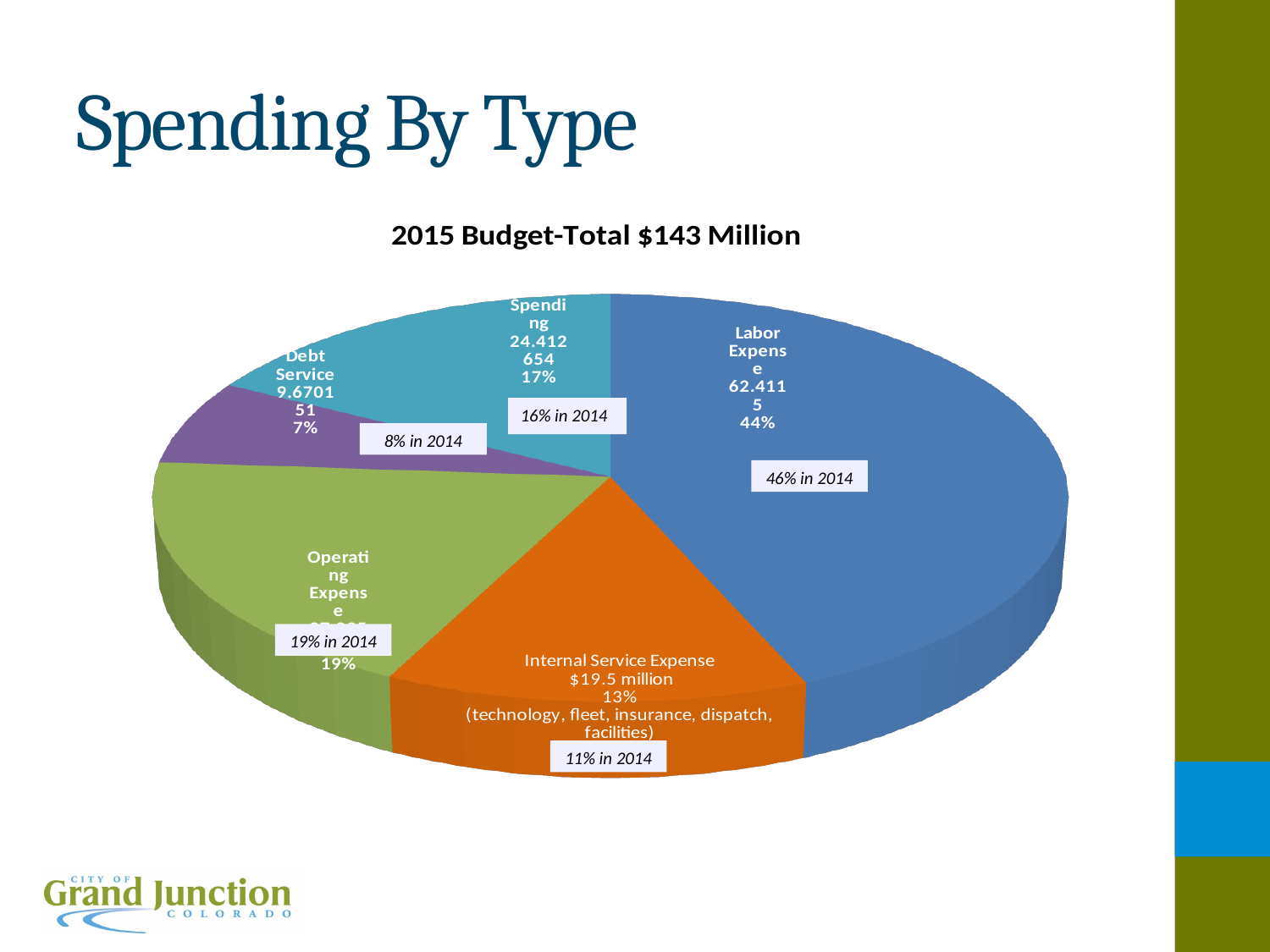
What share of the pie does Internal Service Expense represent? 13% What is the title of the chart? 2015 Budget-Total $143 Million What value is printed on the Debt Service slice? 9.670151 Which is larger, the Operating Expense share or the Internal Service Expense share? Operating Expense How many slices does the pie chart have? 5 What share of the pie does Debt Service represent? 7% Which slice is the largest in the pie chart? Labor Expense What share of the pie does Labor Expense represent? 44% What kind of chart is shown on the slide? Pie chart Which slice is the smallest in the pie chart? Debt Service What value is printed on the Labor Expense slice? 62.4115 According to the callout box, what was the Labor Expense share in 2014? 46% in 2014